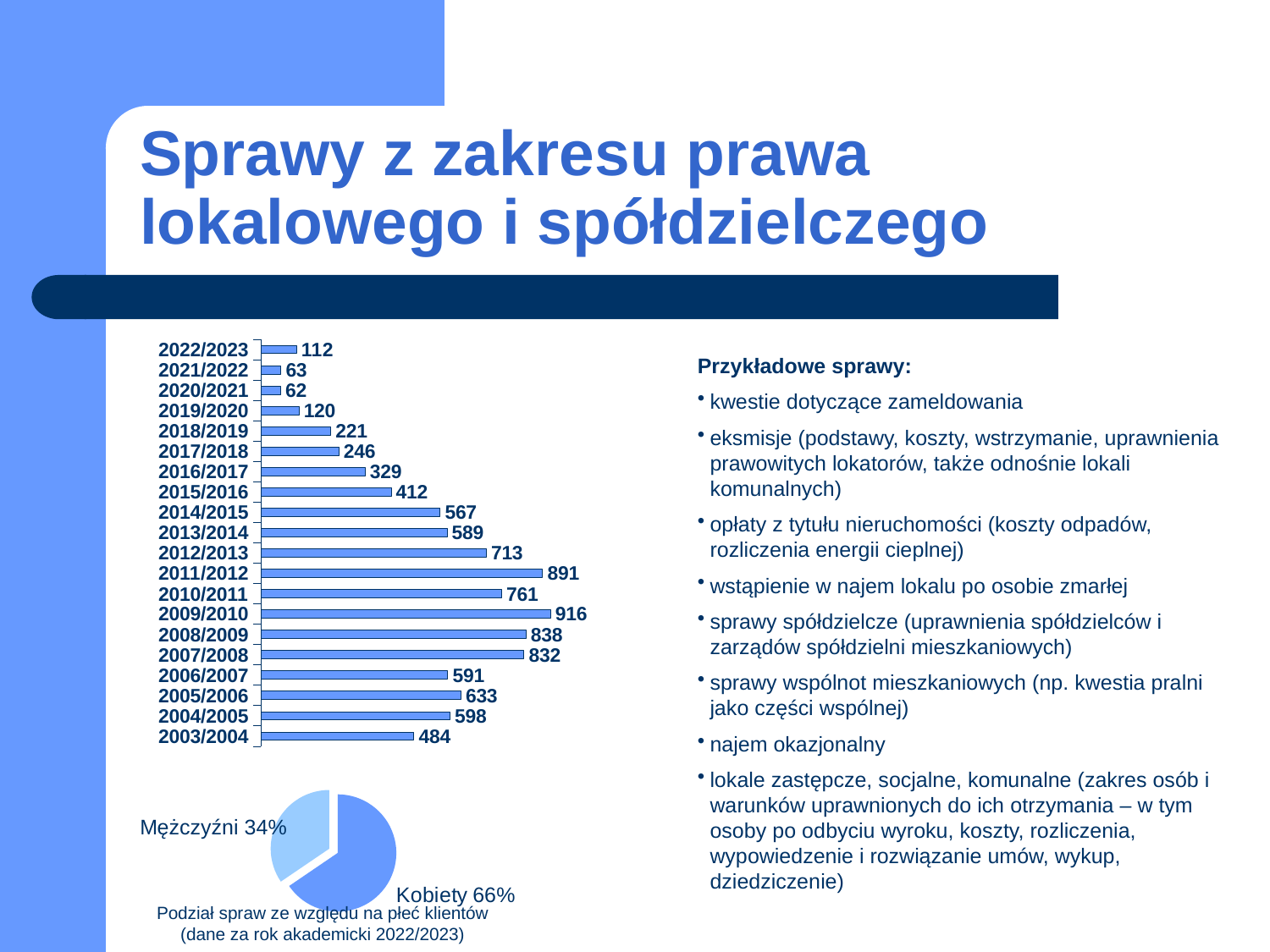
In the bar chart, which is larger: the value for 2012/2013 or the value for 2013/2014? 2012/2013 In the pie chart, what share of cases is for Kobiety? 66% In the bar chart, what is the value for 2022/2023? 112 In the bar chart, what is the difference between the values for 2011/2012 and 2010/2011? 130 In the bar chart, what is the value for 2009/2010? 916 In the bar chart, which academic year has the lowest value? 2020/2021 In the bar chart, which academic year has the highest value? 2009/2010 In the pie chart, what share of cases is for Mężczyźni? 34% In the bar chart, what is the value for 2015/2016? 412 How many academic years are shown in the bar chart? 20 In the bar chart, what is the difference between the values for 2019/2020 and 2021/2022? 57 What kind of chart is the chart showing values by academic year? bar chart